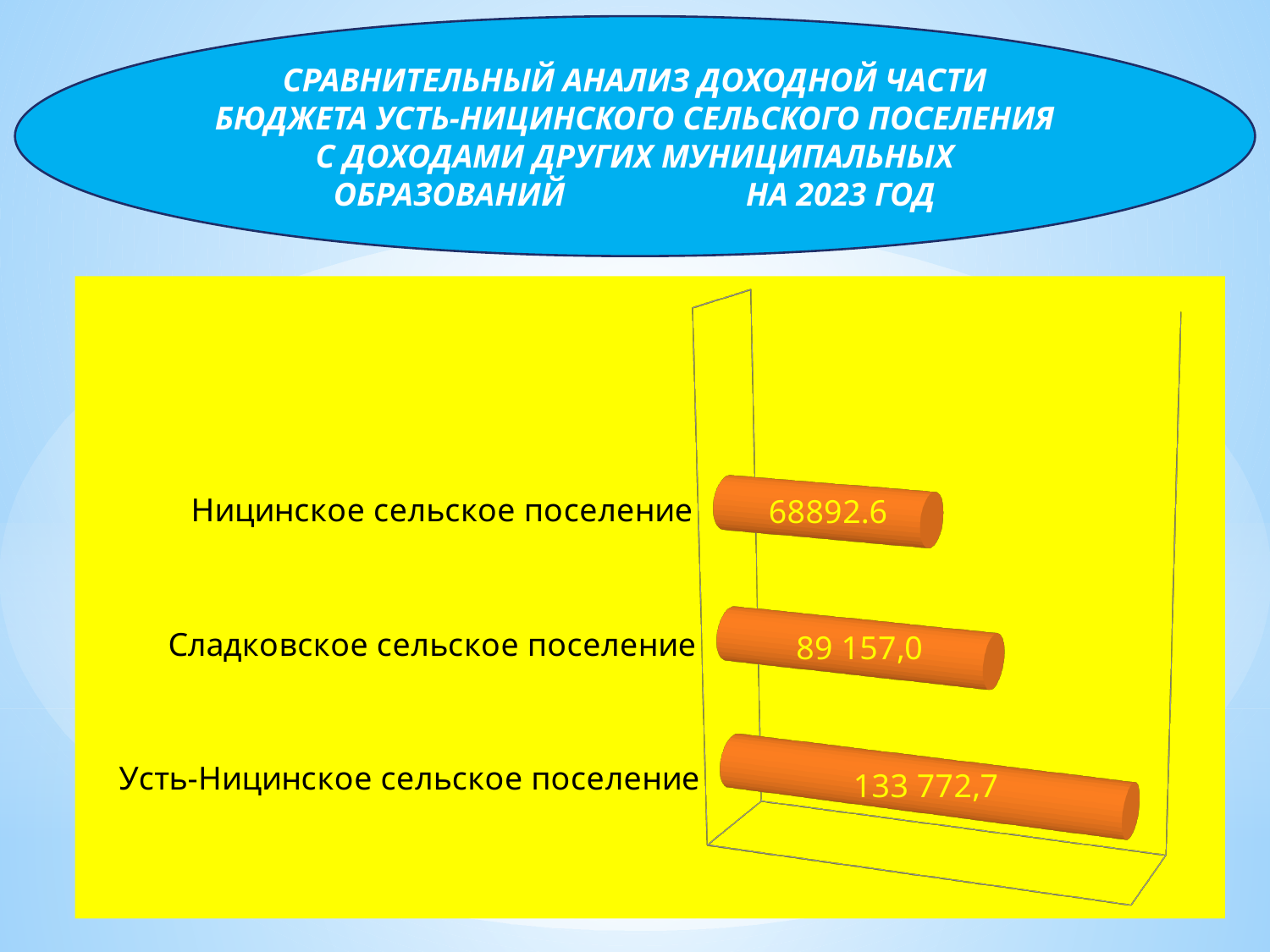
What is the difference between the values for Усть-Ницинское сельское поселение and Сладковское сельское поселение? 44 615,7 What type of chart is shown on the slide? Bar chart What colour are the bars on the chart? Orange Which settlement has the highest value on the chart? Усть-Ницинское сельское поселение What is the value shown for Усть-Ницинское сельское поселение? 133 772,7 What is the difference between the values for Сладковское сельское поселение and Ницинское сельское поселение? 20264.4 Which is larger: the value for Усть-Ницинское сельское поселение or for Сладковское сельское поселение? Усть-Ницинское сельское поселение Which is larger: the value for Сладковское сельское поселение or for Ницинское сельское поселение? Сладковское сельское поселение Which settlement has the lowest value on the chart? Ницинское сельское поселение How many settlements are shown on the chart? 3 What is the value shown for Ницинское сельское поселение? 68892.6 What is the value shown for Сладковское сельское поселение? 89 157,0